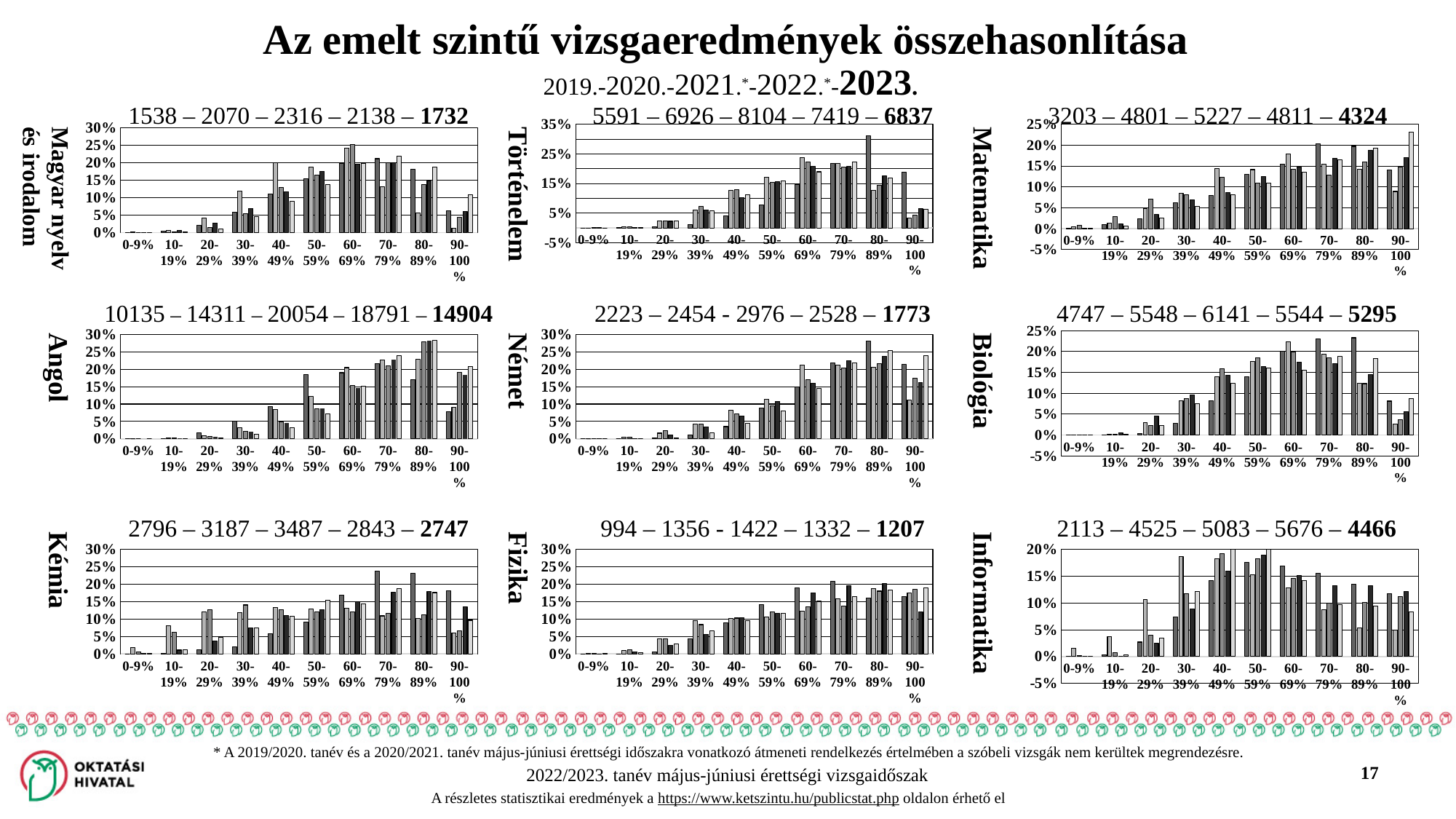
In the Fizika chart, are the bars in the 0-9% group greater or less than 5%? less In the Matematika chart, is the tallest bar in the 90-100% group greater or less than 20%? greater What is the bold 2023 candidate number shown above the Angol chart? 14904 What is the bold 2023 candidate number shown above the Informatika chart? 4466 What kind of chart is used for the Angol (English) results on this slide? bar chart In the Biológia chart, is the tallest bar in the 70-79% group greater or less than 20%? greater How many bars are shown for each score range in the Magyar nyelv és irodalom chart? 5 How many score-range categories are shown on the x axis of the Matematika chart? 10